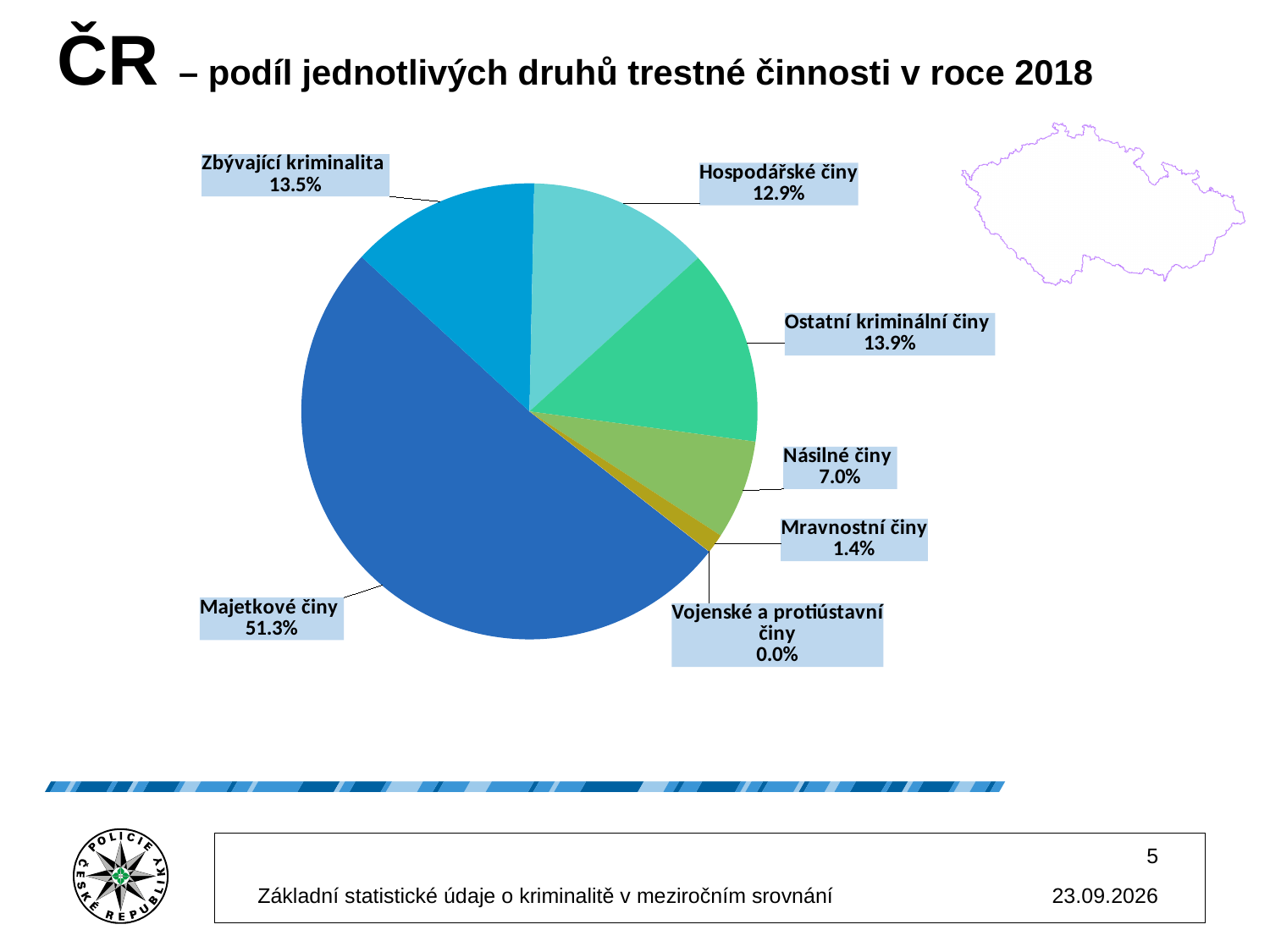
What is the value for Mravnostní činy? 1.4% What type of chart is shown on the slide? Pie chart Which category has the smallest share of the pie? Vojenské a protiústavní činy What percentage is shown for Násilné činy? 7.0% What is the difference between the shares of Majetkové činy and Zbývající kriminalita? 37.8% Which is larger, the share of Násilné činy or the share of Mravnostní činy? Násilné činy What is the value shown for Hospodářské činy? 12.9% What share of the pie does Majetkové činy represent? 51.3% What year does the chart title refer to? 2018 Which category has the largest share of the pie? Majetkové činy How many categories are shown in the pie chart? 7 What is the difference between the shares of Ostatní kriminální činy and Hospodářské činy? 1.0%